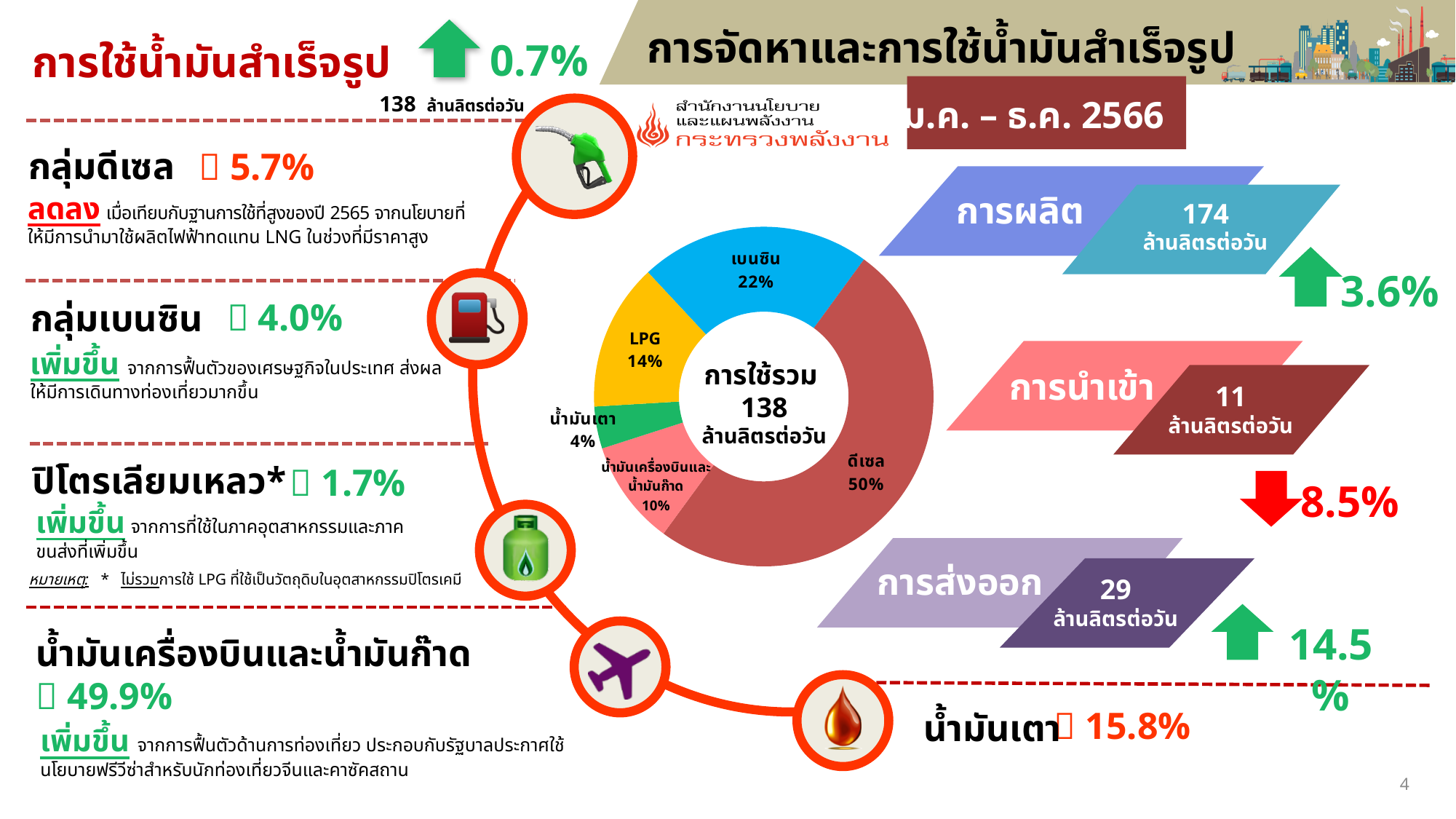
Which category has the largest share in the donut chart? ดีเซล How many categories are shown in the donut chart? 5 What share of the donut chart does ดีเซล account for? 50% What share of the donut chart does เบนซิน account for? 22% What share of the donut chart does น้ำมันเตา account for? 4% What total value is printed in the centre of the donut chart? 138 ล้านลิตรต่อวัน Which has a larger share in the donut chart, LPG or น้ำมันเครื่องบินและน้ำมันก๊าด? LPG What share of the donut chart does น้ำมันเครื่องบินและน้ำมันก๊าด account for? 10% What kind of chart is shown in the centre of the slide? Donut (pie) chart Which category has the smallest share in the donut chart? น้ำมันเตา What is the difference in percentage points between the ดีเซล share and the เบนซิน share in the donut chart? 28 What share of the donut chart does LPG account for? 14%